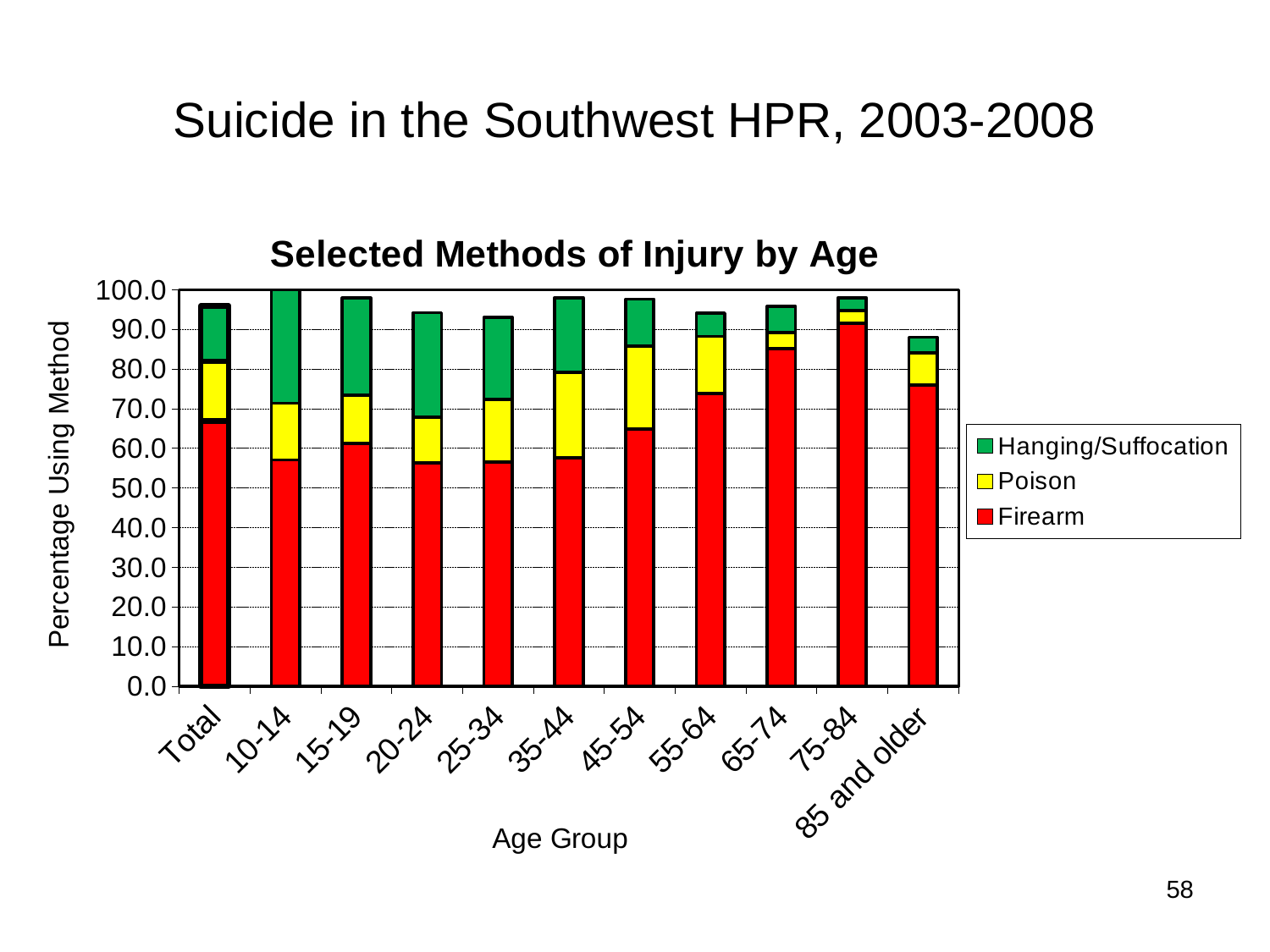
Is the Firearm value for the 75-84 age group greater or less than 90.0? greater Is the Firearm value for the 65-74 age group greater or less than 80.0? greater Which is larger, the Firearm value for 65-74 or for 45-54? 65-74 Is the Firearm value for the 10-14 age group greater or less than 60.0? less How many series does the legend list? 3 Which series is shown in yellow in the legend? Poison What kind of chart is shown on the slide? Stacked bar chart Which age group has the highest Firearm percentage? 75-84 Which age group has the tallest stacked bar overall? 10-14 How many age group categories are shown on the x axis? 11 What is the title of the x axis? Age Group Which is larger, the Hanging/Suffocation segment for 10-14 or for 75-84? 10-14